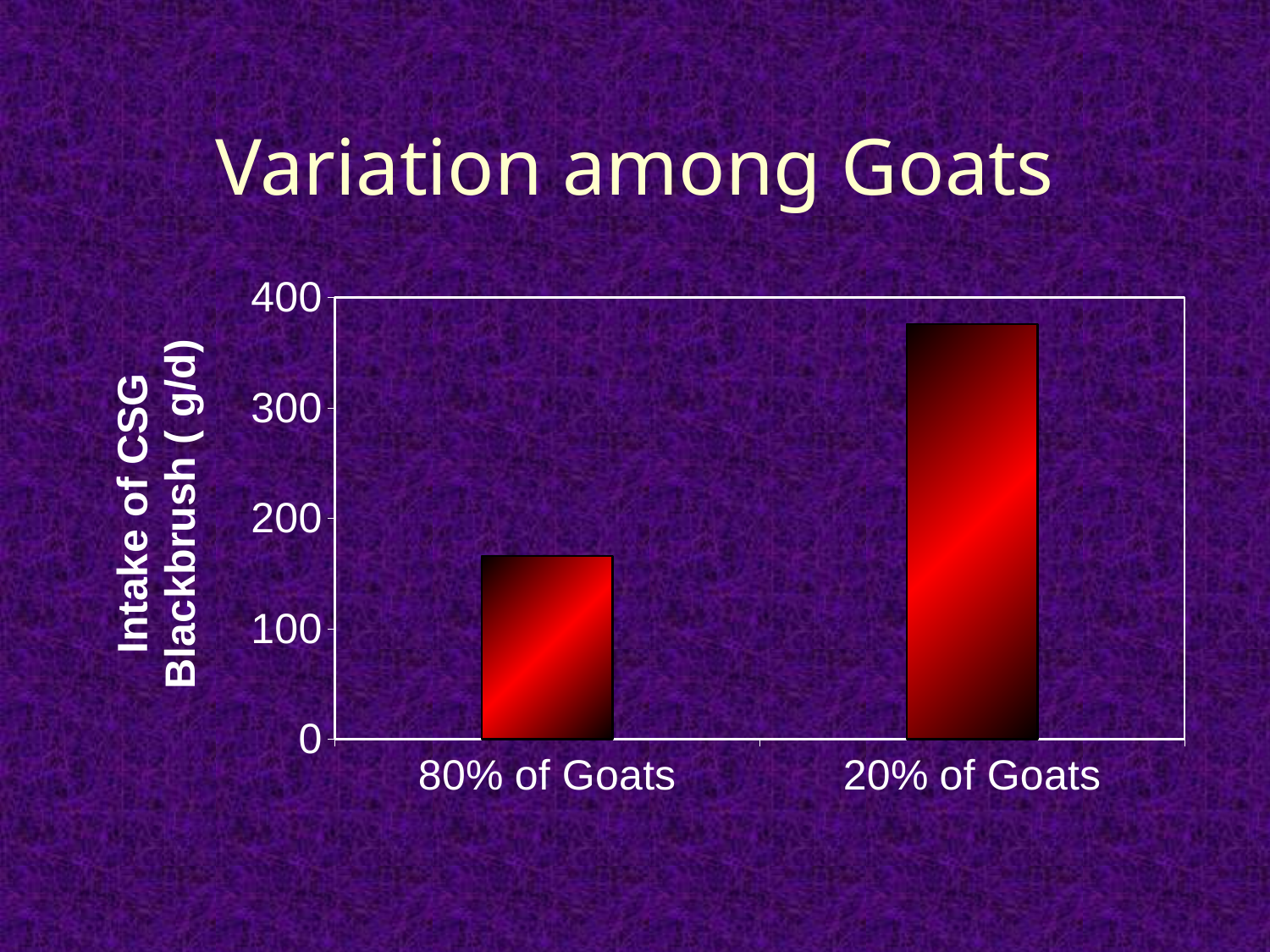
Which is larger, the intake for 80% of Goats or for 20% of Goats? 20% of Goats Is the value for 20% of Goats greater or less than 400? less Which category has the lowest intake of CSG Blackbrush? 80% of Goats How many categories are shown on the x axis of the chart? 2 What is the label on the y axis of the chart? Intake of CSG Blackbrush ( g/d) Which category has the highest intake of CSG Blackbrush? 20% of Goats What kind of chart is shown on the slide? bar chart Do the bar values rise or fall from left to right along the x axis? rise Is the value for 80% of Goats greater or less than 100? greater Is the value for 20% of Goats greater or less than 300? greater What is the title of the slide containing the chart? Variation among Goats